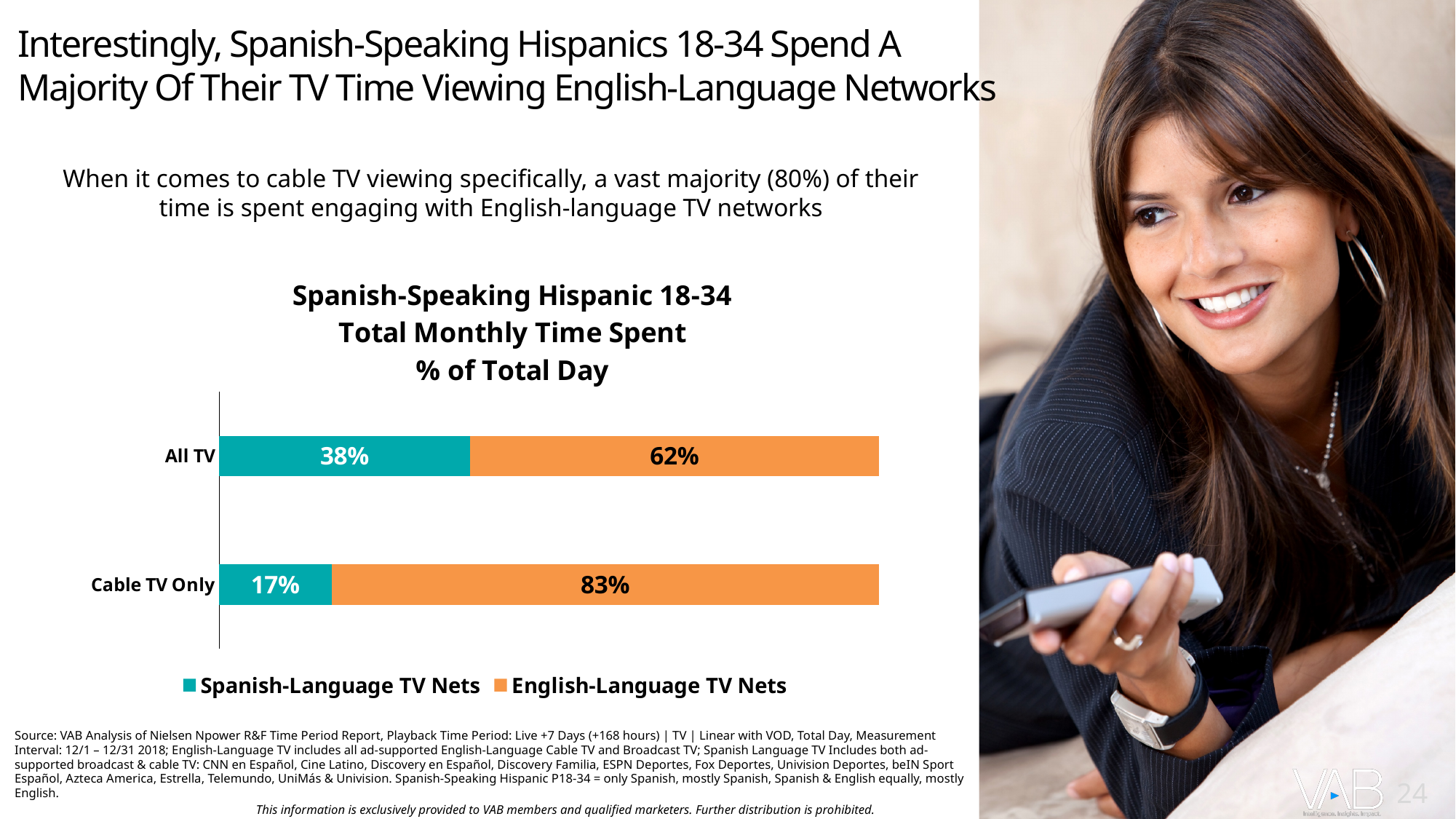
What type of chart is shown on the slide? Stacked bar chart How many categories are shown on the chart? 2 What is the difference between the Spanish-Language and English-Language shares within the All TV bar? 24 percentage points What percentage of Cable TV Only time is spent on English-Language TV Nets? 83% What is the difference between the English-Language TV Nets share for Cable TV Only and for All TV? 21 percentage points Which colour represents English-Language TV Nets in the chart? Orange What percentage of All TV time is spent on Spanish-Language TV Nets? 38% Which category has the lowest share for Spanish-Language TV Nets? Cable TV Only Which category has the higher share for English-Language TV Nets, All TV or Cable TV Only? Cable TV Only What percentage of Cable TV Only time is spent on Spanish-Language TV Nets? 17% How many series does the legend list? 2 What percentage of All TV time is spent on English-Language TV Nets? 62%